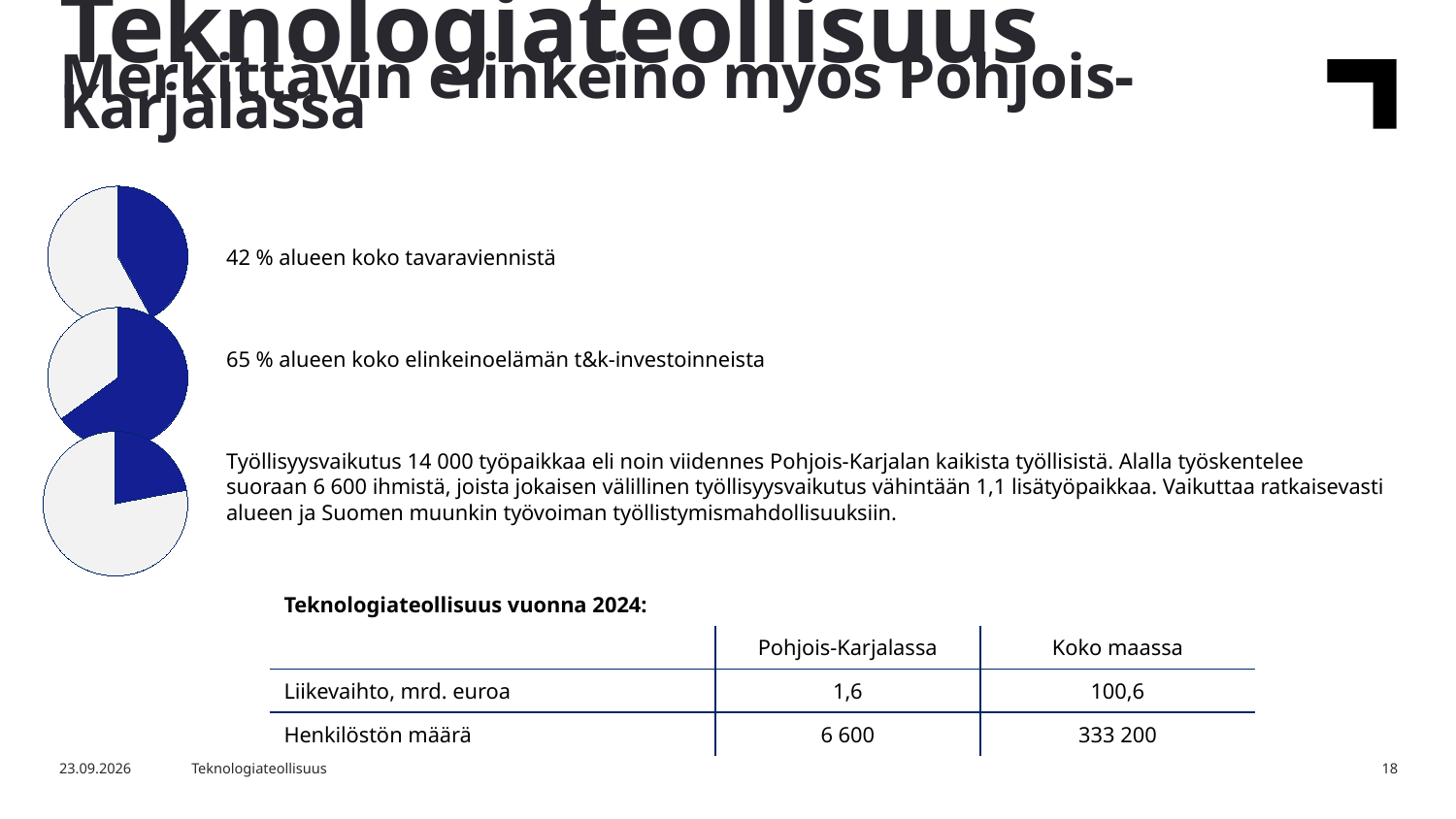
In the middle pie chart, is the blue slice more or less than half of the pie? More Which of the three pie charts has the largest blue slice? The middle pie chart (65 %) How many slices does each pie chart have? 2 How many pie charts are shown on the slide? 3 In the top pie chart, what share of the region's total goods exports (tavaravienti) does the blue slice represent, according to the text next to it? 42 % In the middle pie chart, what share of the region's business R&D investments (t&k-investoinnit) does the blue slice represent, according to the text next to it? 65 % Is the blue slice larger in the top pie chart or in the middle pie chart? The middle pie chart What two colours are used for the slices in the pie charts? Dark blue and light grey What is the difference in percentage points between the blue share in the middle pie chart (65 %) and the top pie chart (42 %)? 23 percentage points What kind of chart are the three charts on the left side of the slide? Pie charts Which of the three pie charts has the smallest blue slice? The bottom pie chart